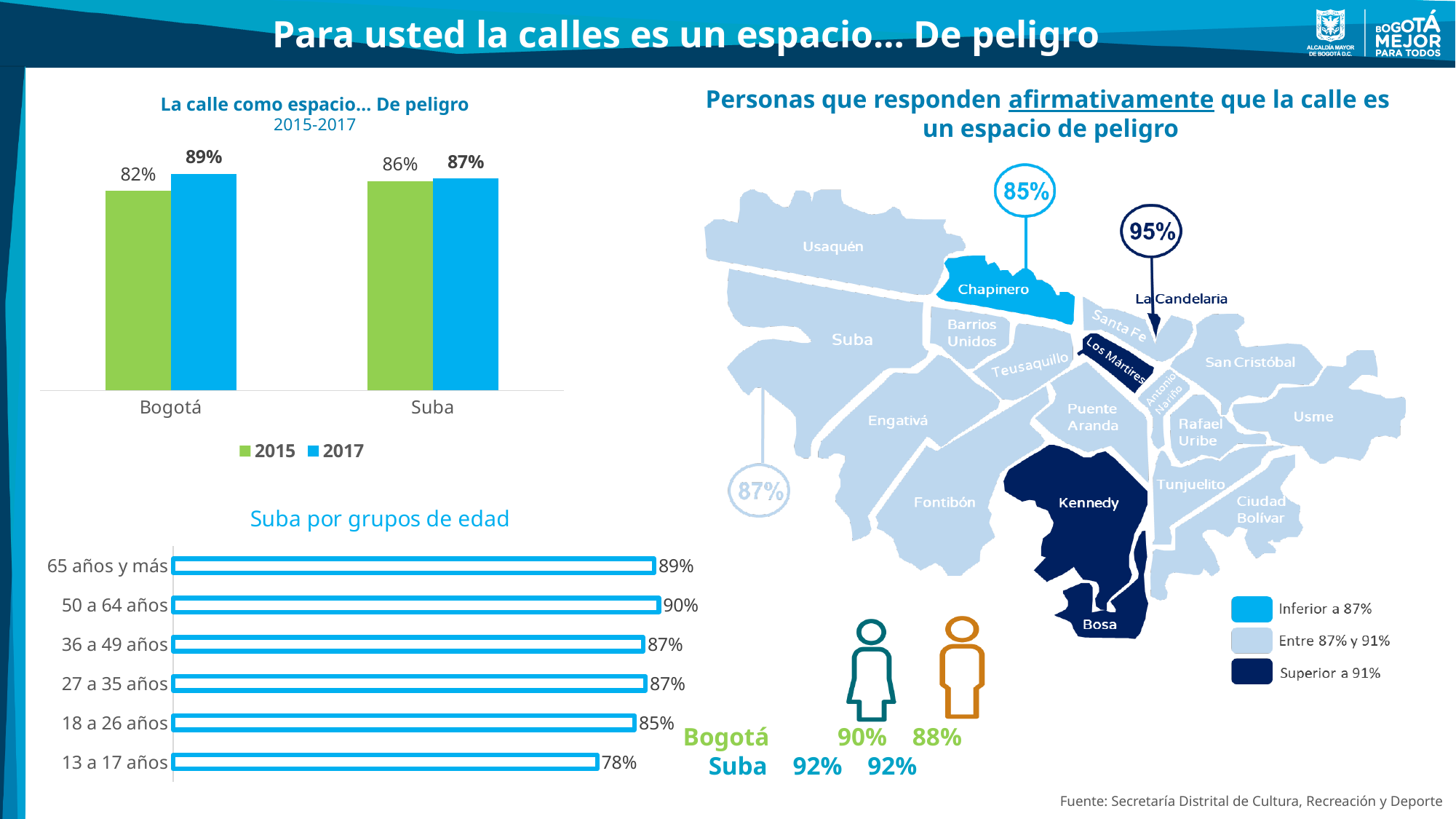
In the chart 'Suba por grupos de edad', what is the value for the 13 a 17 años group? 78% In the chart 'Suba por grupos de edad', what is the value for the 36 a 49 años group? 87% In the chart 'La calle como espacio… De peligro', by how many percentage points did Bogotá's value change from 2015 to 2017? 7 percentage points What type of chart is 'La calle como espacio… De peligro'? Bar chart In the chart 'Suba por grupos de edad', what is the difference between the 65 años y más group and the 18 a 26 años group? 4 percentage points In the chart 'La calle como espacio… De peligro', what is the value for Bogotá in 2017? 89% How many age groups are shown in the chart 'Suba por grupos de edad'? 6 How many series does the legend of the chart 'La calle como espacio… De peligro' list? 2 In the chart 'Suba por grupos de edad', which age group has the lowest value? 13 a 17 años In the chart 'Suba por grupos de edad', which age group has the highest value? 50 a 64 años In the chart 'La calle como espacio… De peligro', which is larger: Bogotá in 2015 or Suba in 2015? Suba in 2015 In the chart 'La calle como espacio… De peligro', what is the value for Suba in 2015? 86%